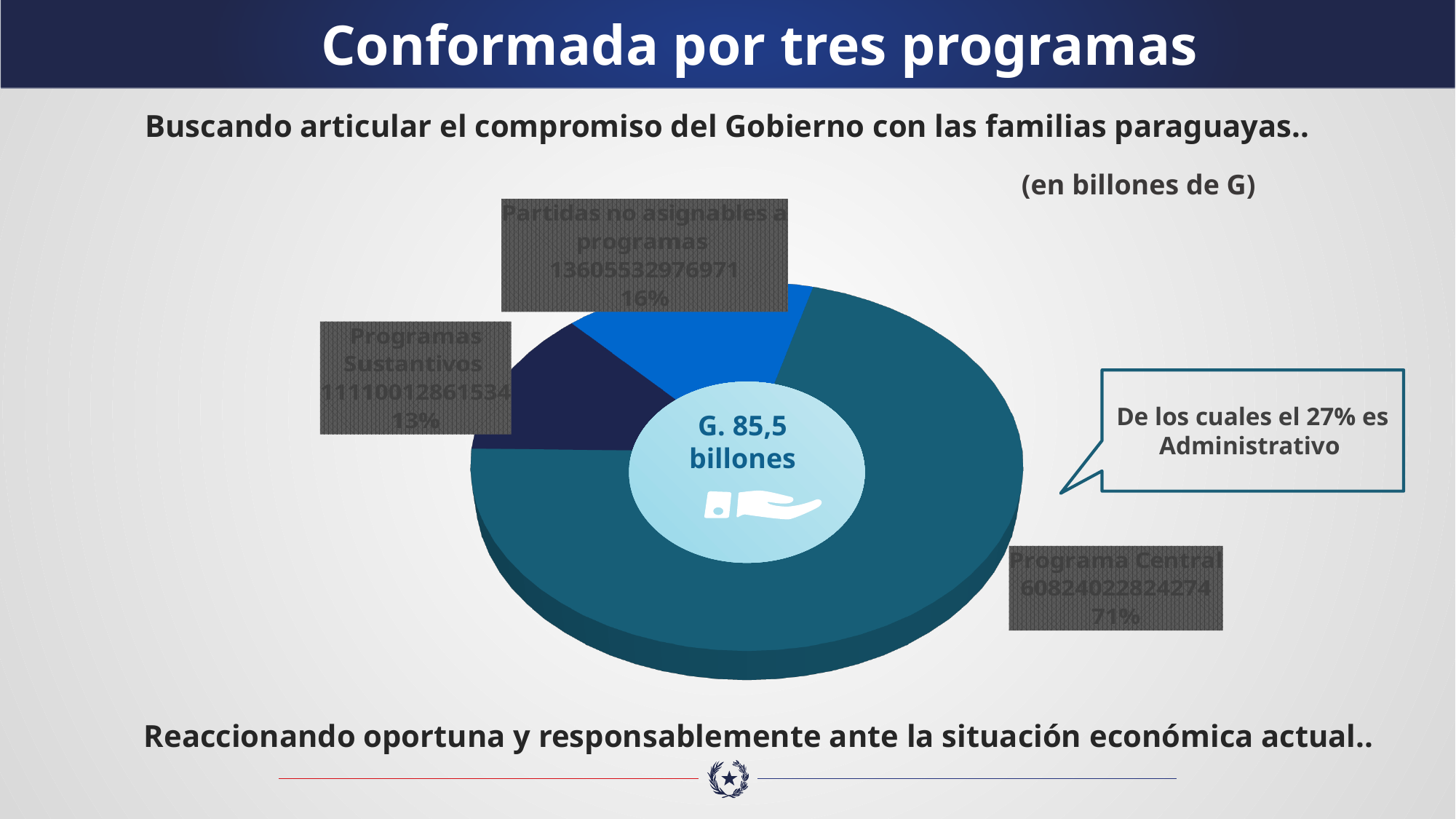
What percentage share does the Partidas no asignables a programas slice have? 16% What percentage share does the Programas Sustantivos slice have? 13% What is the difference in percentage points between the Programa Central share and the Partidas no asignables a programas share? 55 According to the callout next to the pie chart, what percentage of the Programa Central is Administrativo? 27% What is the value shown for the Programa Central slice? 60824022824274 Which slice of the pie chart is the largest? Programa Central What total amount is shown in the centre of the pie chart? G. 85,5 billones What kind of chart is shown on the slide? pie chart How many slices does the pie chart have? 3 Which has a larger share, Programas Sustantivos or Partidas no asignables a programas? Partidas no asignables a programas Which slice of the pie chart is the smallest? Programas Sustantivos What percentage share does the Programa Central slice have? 71%